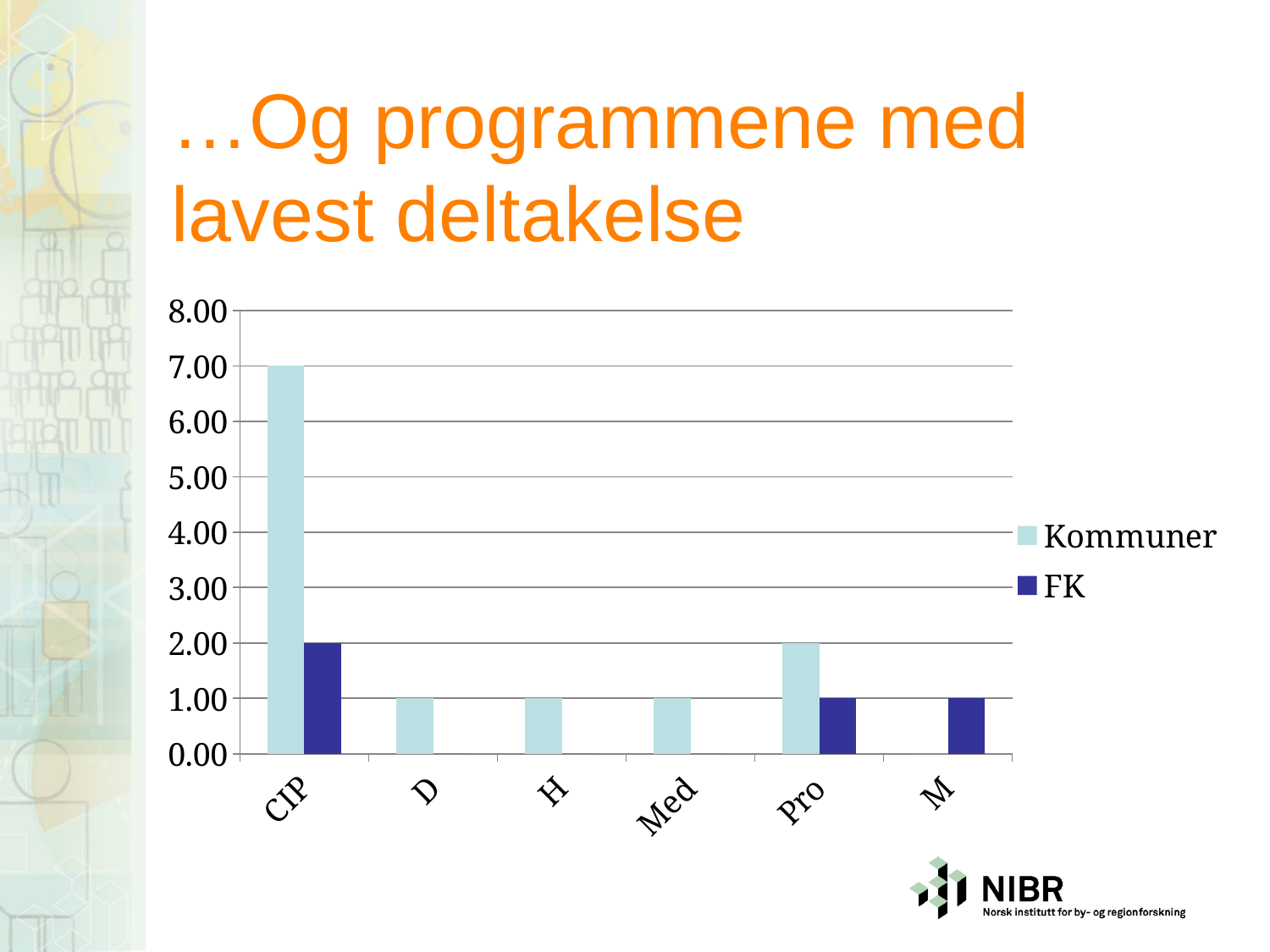
Which category has the highest FK value? CIP What is the Kommuner value for Pro? 2.00 Which is larger for Pro, the Kommuner value or the FK value? Kommuner How many categories are shown on the x axis? 6 Is the Kommuner value for CIP greater or less than 5.00? greater What is the Kommuner value for CIP? 7.00 What is the FK value for M? 1.00 What kind of chart is shown on the slide? Bar chart What is the FK value for CIP? 2.00 Which category has the highest Kommuner value? CIP What is the difference between the Kommuner and FK values for CIP? 5.00 How many series does the legend list? 2